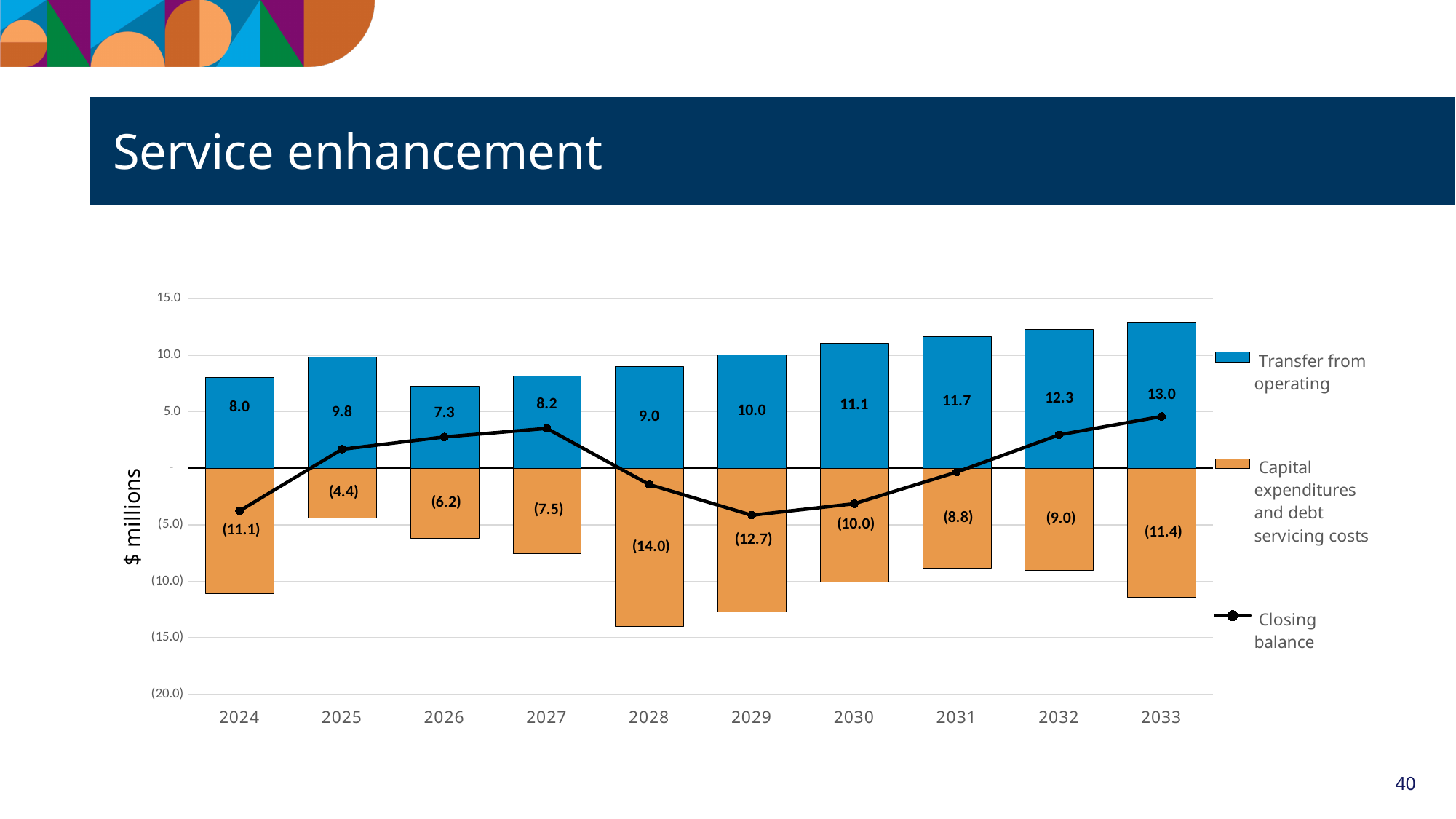
Does the Transfer from operating rise or fall from 2027 to 2033? rise What is the difference between the Transfer from operating values for 2033 and 2024? 5.0 Which year has the highest Transfer from operating? 2033 How many series does the legend list? 3 What is the value of Transfer from operating for 2024? 8.0 How many years are shown on the x axis? 10 What is the Transfer from operating value for 2030? 11.1 Which year has the lowest Transfer from operating? 2026 Which is larger, the Transfer from operating in 2025 or in 2028? 2025 What is the value shown for Capital expenditures and debt servicing costs in 2028? (14.0) Is the Closing balance for 2024 greater or less than zero? less Which year has the smallest Capital expenditures and debt servicing costs bar? 2025